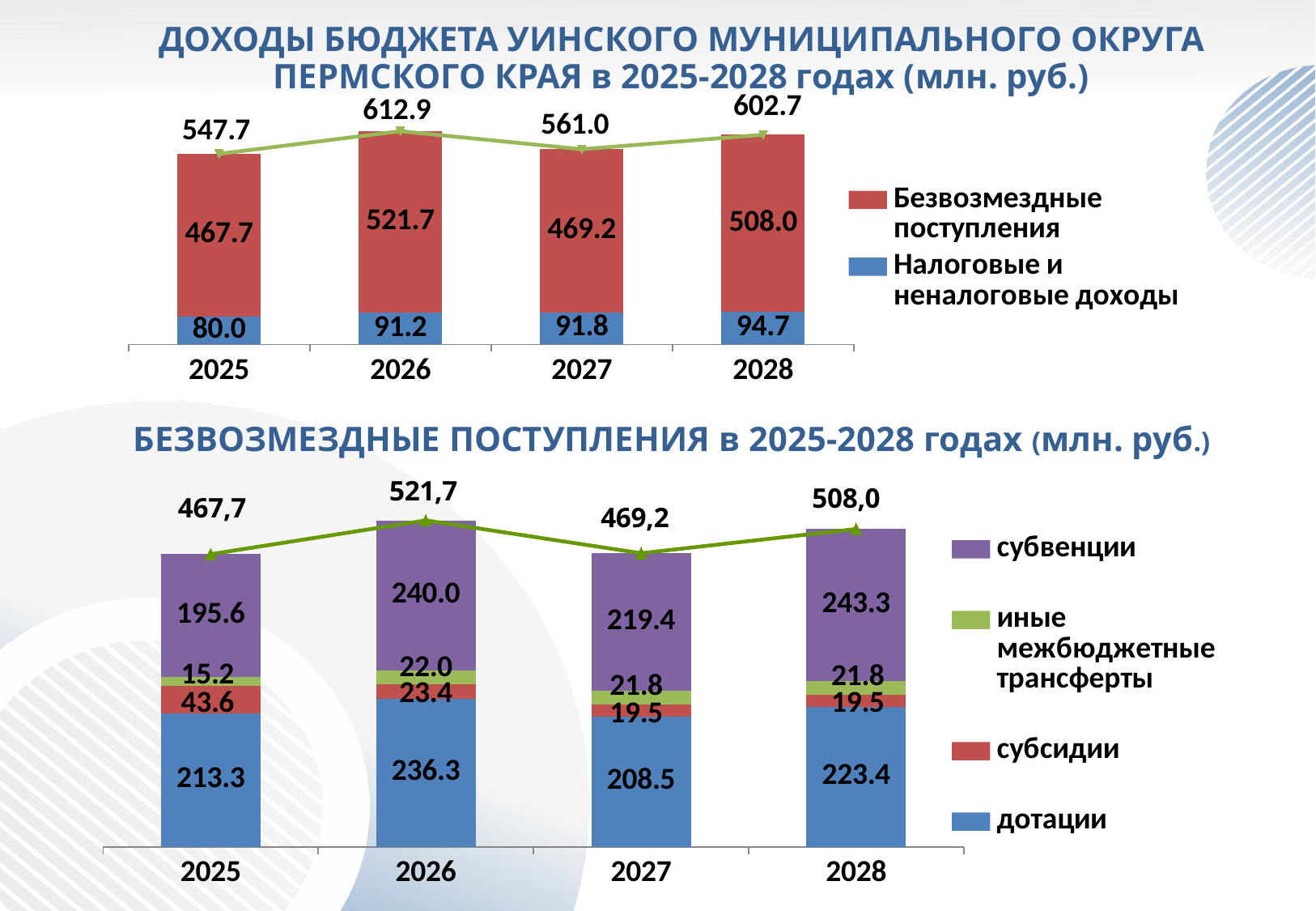
In the bottom chart (БЕЗВОЗМЕЗДНЫЕ ПОСТУПЛЕНИЯ), what is the value of дотации for 2027? 208.5 In the bottom chart, is the value of субвенции for 2026 larger or smaller than the value of дотации for 2026? larger What kind of chart is the bottom chart? Stacked bar chart with a line In the top chart (ДОХОДЫ БЮДЖЕТА УИНСКОГО МУНИЦИПАЛЬНОГО ОКРУГА), what is the value of Налоговые и неналоговые доходы for 2026? 91.2 In the bottom chart, how many series does the legend list? 4 In the top chart, which year has the lowest total budget income? 2025 In the bottom chart, what is the value of субвенции for 2028? 243.3 In the bottom chart, which year has the highest value of субсидии? 2025 In the top chart, how many series does the legend list? 2 In the top chart, what is the difference between the total for 2026 and the total for 2025? 65.2 In the top chart, what is the value of Безвозмездные поступления for 2028? 508.0 In the top chart, which year has the highest total budget income? 2026